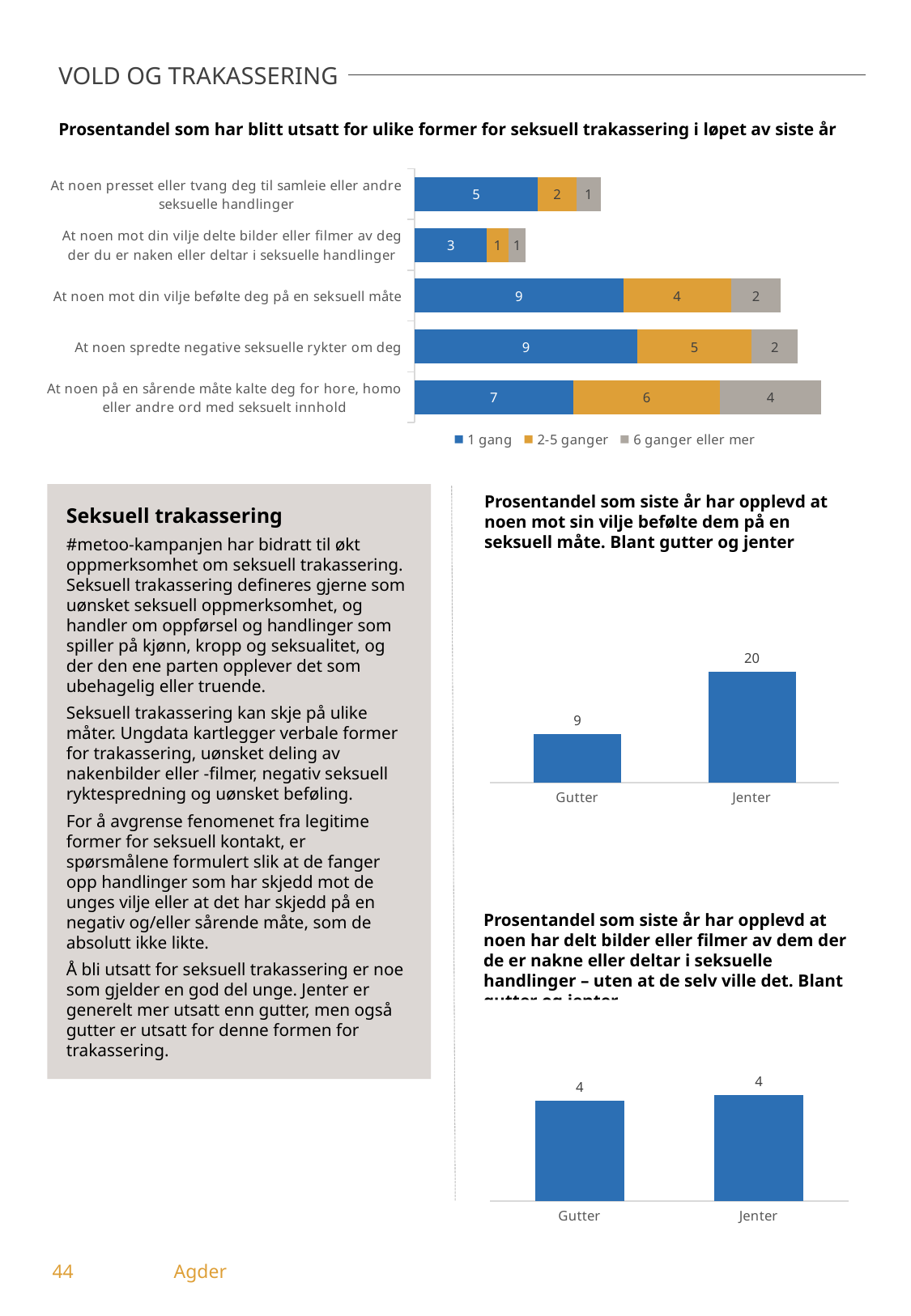
In the top chart, what is the difference between the '2-5 ganger' values for 'At noen på en sårende måte kalte deg for hore, homo eller andre ord med seksuelt innhold' and 'At noen presset eller tvang deg til samleie eller andre seksuelle handlinger'? 4 What kind of chart is the top chart on the slide? Stacked bar chart In the top chart, which category has the lowest '1 gang' value? At noen mot din vilje delte bilder eller filmer av deg der du er naken eller deltar i seksuelle handlinger In the bottom chart about 'delt bilder eller filmer', what is the value for Gutter? 4 How many series does the legend of the top chart list? 3 How many categories are shown in the top chart? 5 In the middle chart 'Prosentandel som siste år har opplevd at noen mot sin vilje befølte dem på en seksuell måte', what is the value for Jenter? 20 In the top chart, what is the total of the stacked bar for 'At noen presset eller tvang deg til samleie eller andre seksuelle handlinger'? 8 In the top chart 'Prosentandel som har blitt utsatt for ulike former for seksuell trakassering i løpet av siste år', what is the '1 gang' value for 'At noen mot din vilje befølte deg på en seksuell måte'? 9 In the top chart, what is the total of the stacked bar for 'At noen spredte negative seksuelle rykter om deg'? 16 In the middle chart about 'befølte dem på en seksuell måte', what is the difference between Jenter and Gutter? 11 In the top chart, what is the '6 ganger eller mer' value for 'At noen på en sårende måte kalte deg for hore, homo eller andre ord med seksuelt innhold'? 4